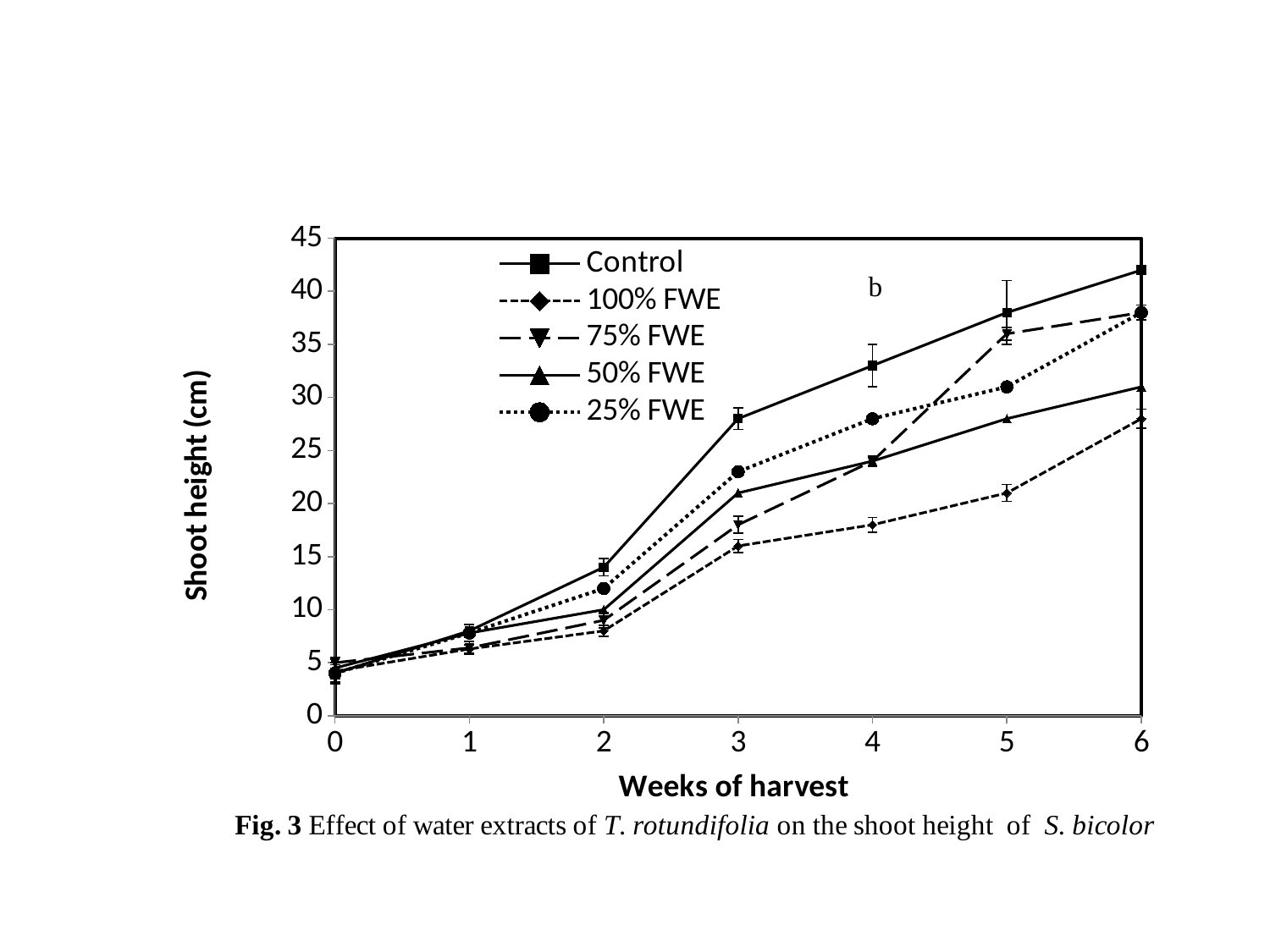
Which series has the lowest shoot height at week 6? 100% FWE Which series has the highest shoot height at week 6? Control How many week points are plotted along the x axis? 7 How many series does the legend list? 5 Is the shoot height for Control at week 6 greater or less than 40? greater Is the shoot height for 25% FWE at week 4 greater or less than 25? greater What is the title of the y axis? Shoot height (cm) What kind of chart is shown on the slide? line chart Does the shoot height for Control rise or fall from week 0 to week 6? rise At week 3, which has the greater shoot height, 25% FWE or 75% FWE? 25% FWE At week 5, which has the greater shoot height, Control or 50% FWE? Control Is the shoot height for 100% FWE at week 3 greater or less than 20? less